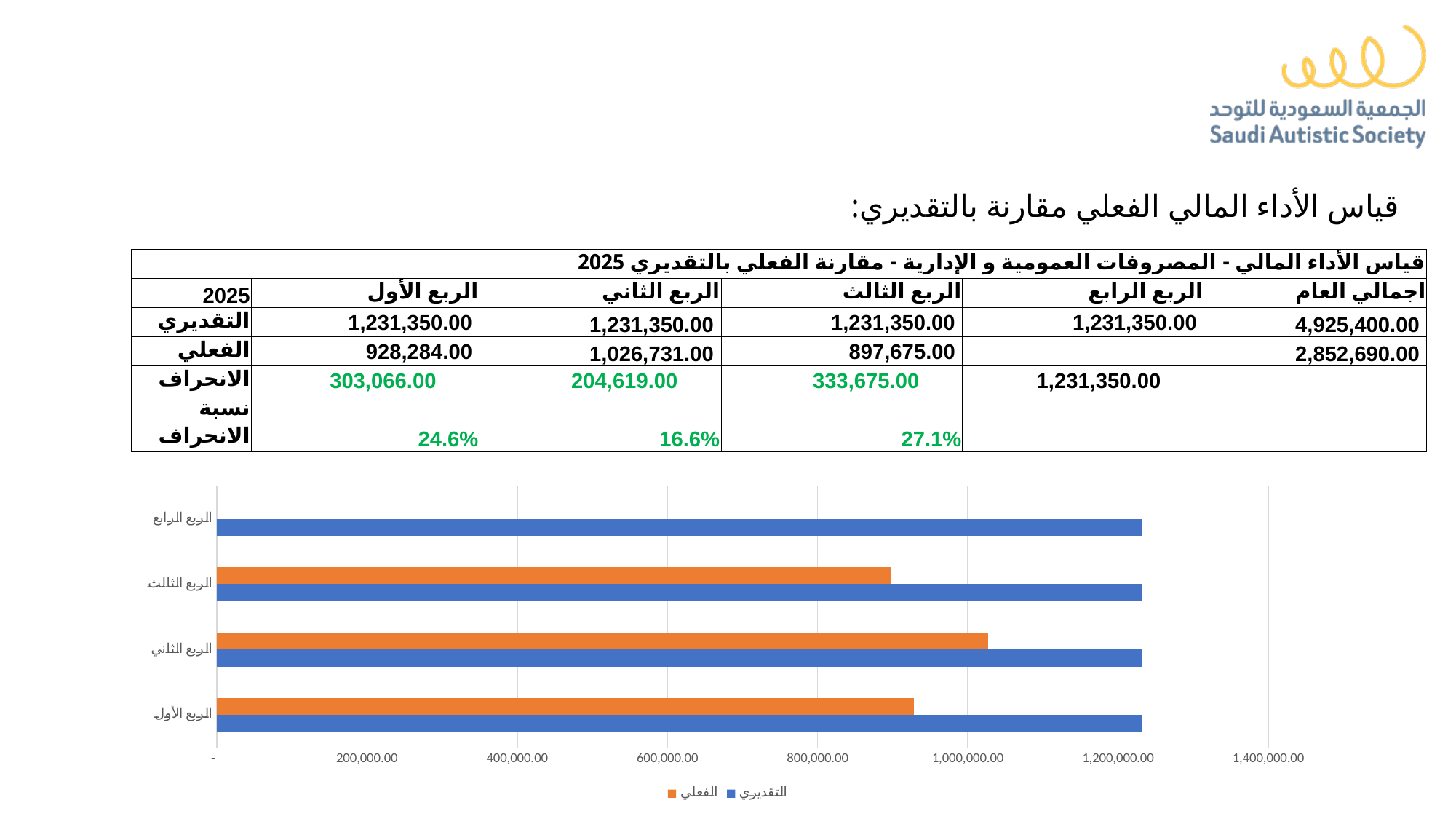
What kind of chart is shown at the bottom of the slide? bar chart What is the الفعلي value for الربع الثاني? 1,026,731.00 Which quarter has the highest الفعلي value on the chart? الربع الثاني Is the التقديري value for الربع الأول greater or less than 1,200,000.00? greater Is the الفعلي value for الربع الثالث greater or less than 1,000,000.00? less For الربع الأول, which is larger: التقديري or الفعلي? التقديري Is the الفعلي value for الربع الثاني greater or less than 1,000,000.00? greater Which series is drawn in orange on the chart? الفعلي How many series does the chart legend list? 2 What is the difference between التقديري and الفعلي for الربع الأول? 303,066.00 How many quarters (categories) are plotted on the chart? 4 What is the التقديري value for الربع الرابع? 1,231,350.00